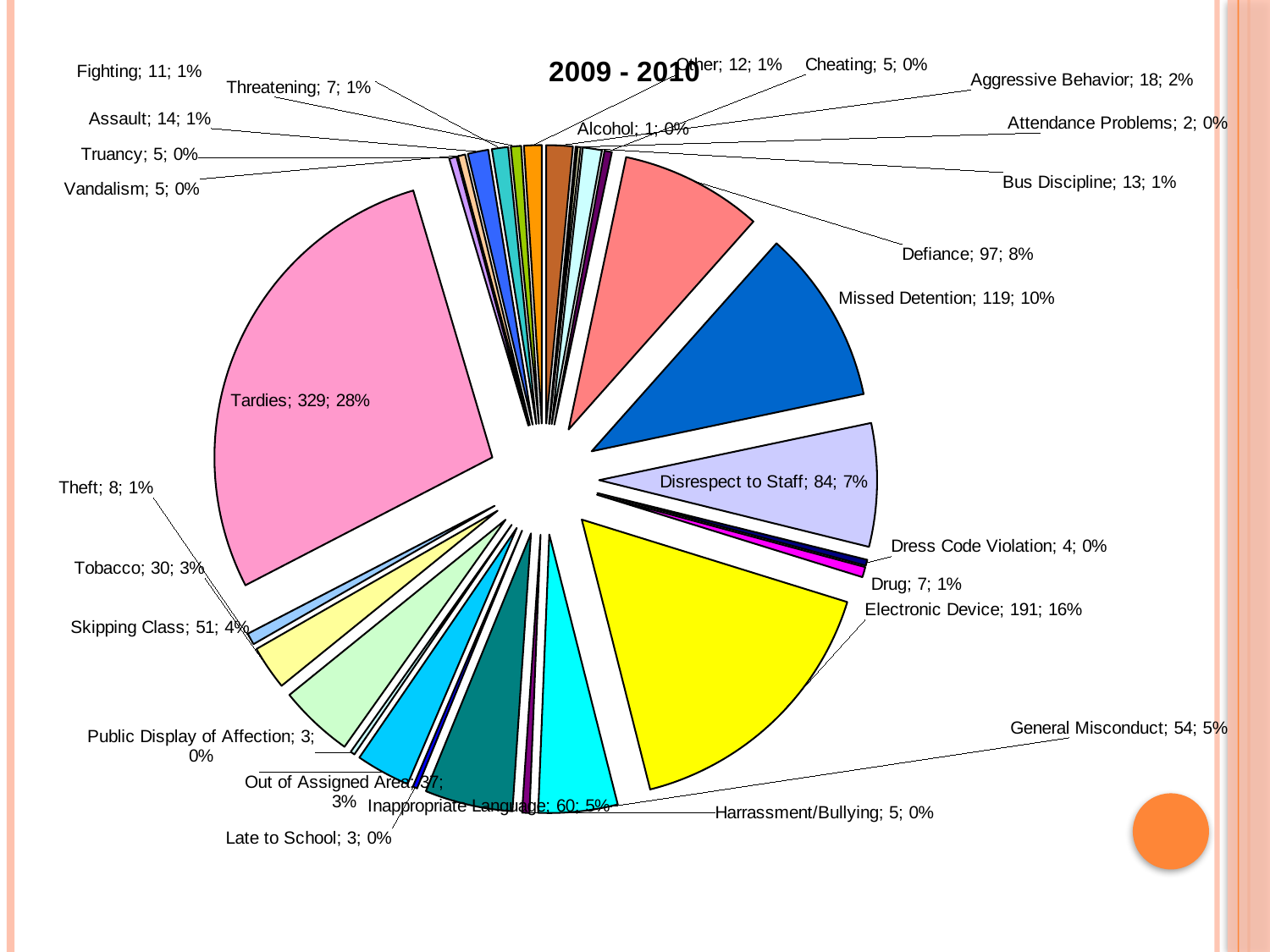
What is the value for Tardies? 329 Which is larger, the value for Disrespect to Staff or the value for Defiance? Defiance What is the value for Missed Detention? 119 What type of chart is shown on the slide? pie chart Which category has the largest slice of the pie? Tardies What share of the pie does Defiance represent? 8% What is the value for Electronic Device? 191 What is the difference between the values for Tardies and Electronic Device? 138 Which category has the smallest value? Alcohol What share of the pie does Electronic Device represent? 16% What is the value for Skipping Class? 51 What is the title of the chart? 2009 - 2010